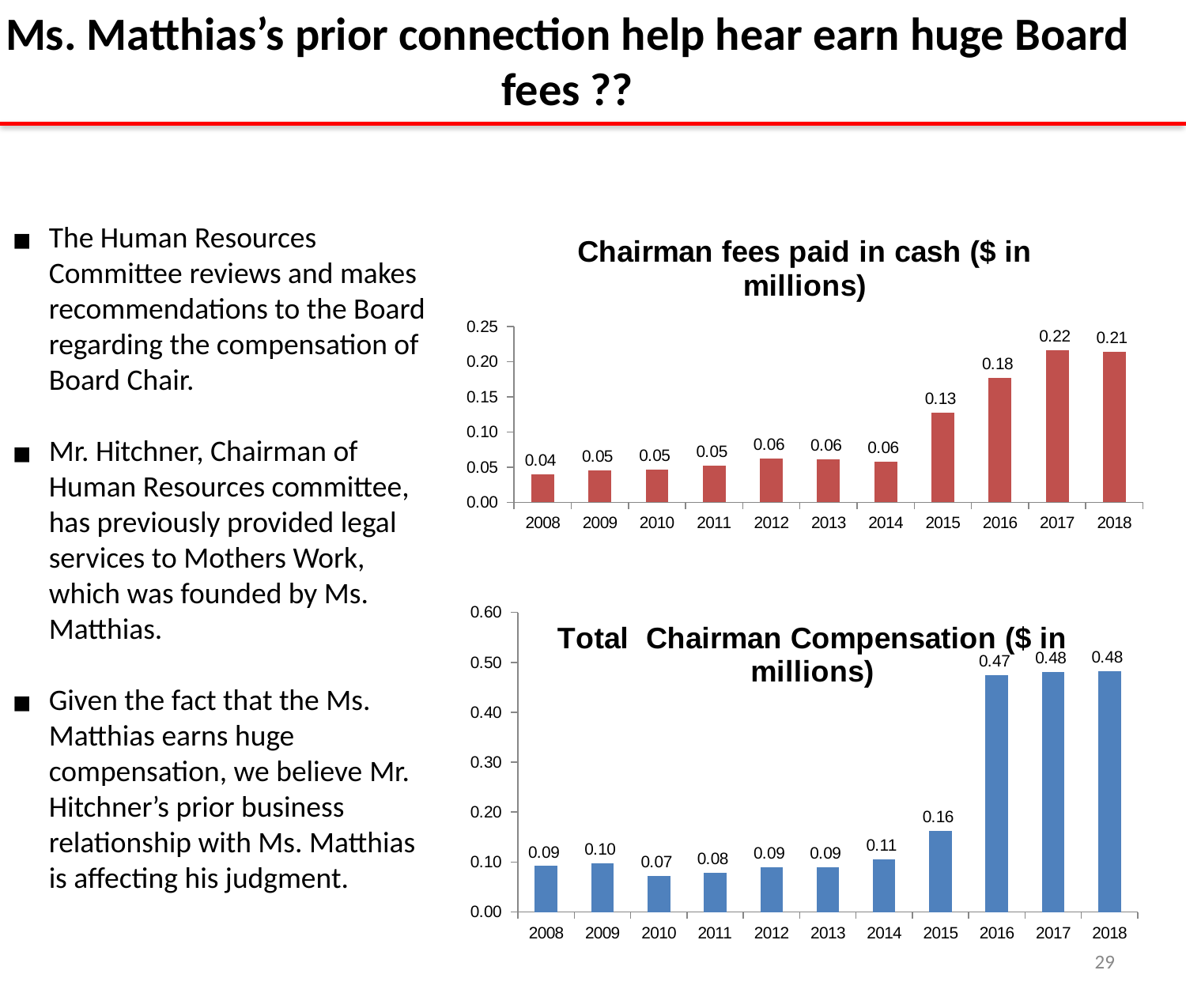
In the 'Chairman fees paid in cash ($ in millions)' chart, what is the value for 2015? 0.13 In the 'Total Chairman Compensation ($ in millions)' chart, which year has the larger value, 2009 or 2010? 2009 In the 'Total Chairman Compensation ($ in millions)' chart, what is the value for 2016? 0.47 In the 'Chairman fees paid in cash ($ in millions)' chart, which year has the lowest value? 2008 In the 'Chairman fees paid in cash ($ in millions)' chart, what is the difference between the values for 2017 and 2008? 0.18 In the 'Chairman fees paid in cash ($ in millions)' chart, which year has the highest value? 2017 In the 'Total Chairman Compensation ($ in millions)' chart, what is the value for 2014? 0.11 In the 'Chairman fees paid in cash ($ in millions)' chart, what is the value for 2018? 0.21 How many years are shown on the x axis of the 'Chairman fees paid in cash ($ in millions)' chart? 11 In the 'Total Chairman Compensation ($ in millions)' chart, what is the difference between the values for 2016 and 2015? 0.31 What type of chart is the 'Total Chairman Compensation ($ in millions)' chart? Bar chart In the 'Total Chairman Compensation ($ in millions)' chart, which year has the lowest value? 2010